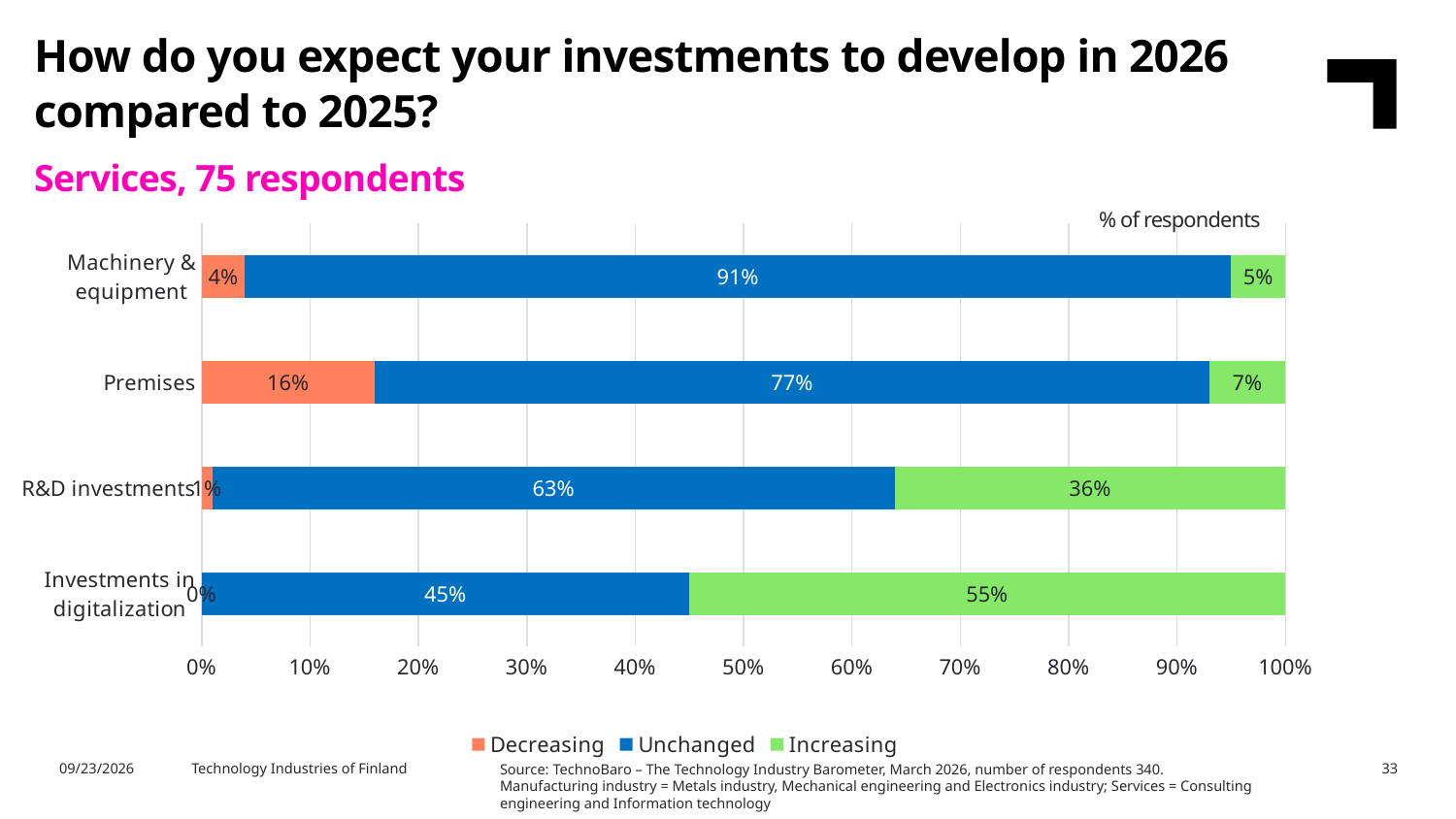
How many series does the legend list? 3 What percentage of respondents expect Machinery & equipment investments to remain unchanged? 91% Which category has the lowest share of respondents expecting a decrease? Investments in digitalization Which category has the highest share of respondents expecting an increase? Investments in digitalization What percentage of respondents expect Investments in digitalization to increase? 55% Which colour represents the Increasing series in the chart? Green What is the difference between the Increasing share for Investments in digitalization and for R&D investments? 19 percentage points What percentage of respondents expect R&D investments to increase? 36% Which is larger: the Unchanged share for Premises or the Unchanged share for R&D investments? Premises How many investment categories are shown in the chart? 4 What percentage of respondents expect Premises investments to decrease? 16% What kind of chart is shown on the slide? Stacked bar chart